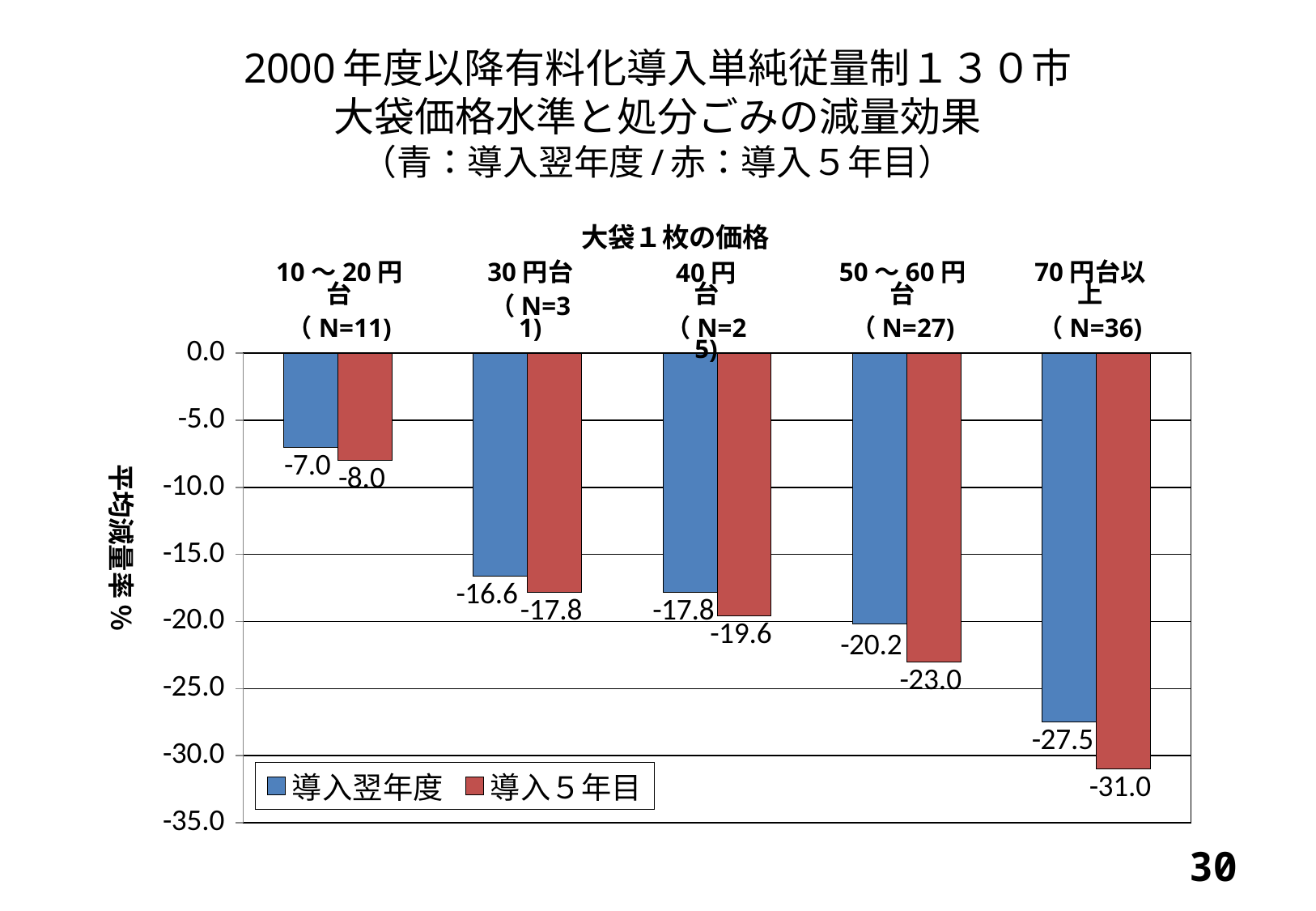
What is the value for 導入翌年度 in the 10～20円台 category? -7.0 How many price categories are plotted on the x axis? 5 What type of chart is shown on the slide? bar chart Which price category has the lowest (most negative) value for 導入５年目? 70円台以上 What is the difference between the 導入翌年度 and 導入５年目 values in the 70円台以上 category? 3.5 What is the value for 導入５年目 in the 50～60円台 category? -23.0 Which price category has the highest (least negative) value for 導入翌年度? 10～20円台 Which colour represents the 導入５年目 series in the legend? red What is the value for 導入５年目 in the 40円台 category? -19.6 What is the value for 導入翌年度 in the 70円台以上 category? -27.5 How many series does the legend list? 2 Which is larger in magnitude, the 導入５年目 value for 30円台 or the 導入５年目 value for 50～60円台? 50～60円台